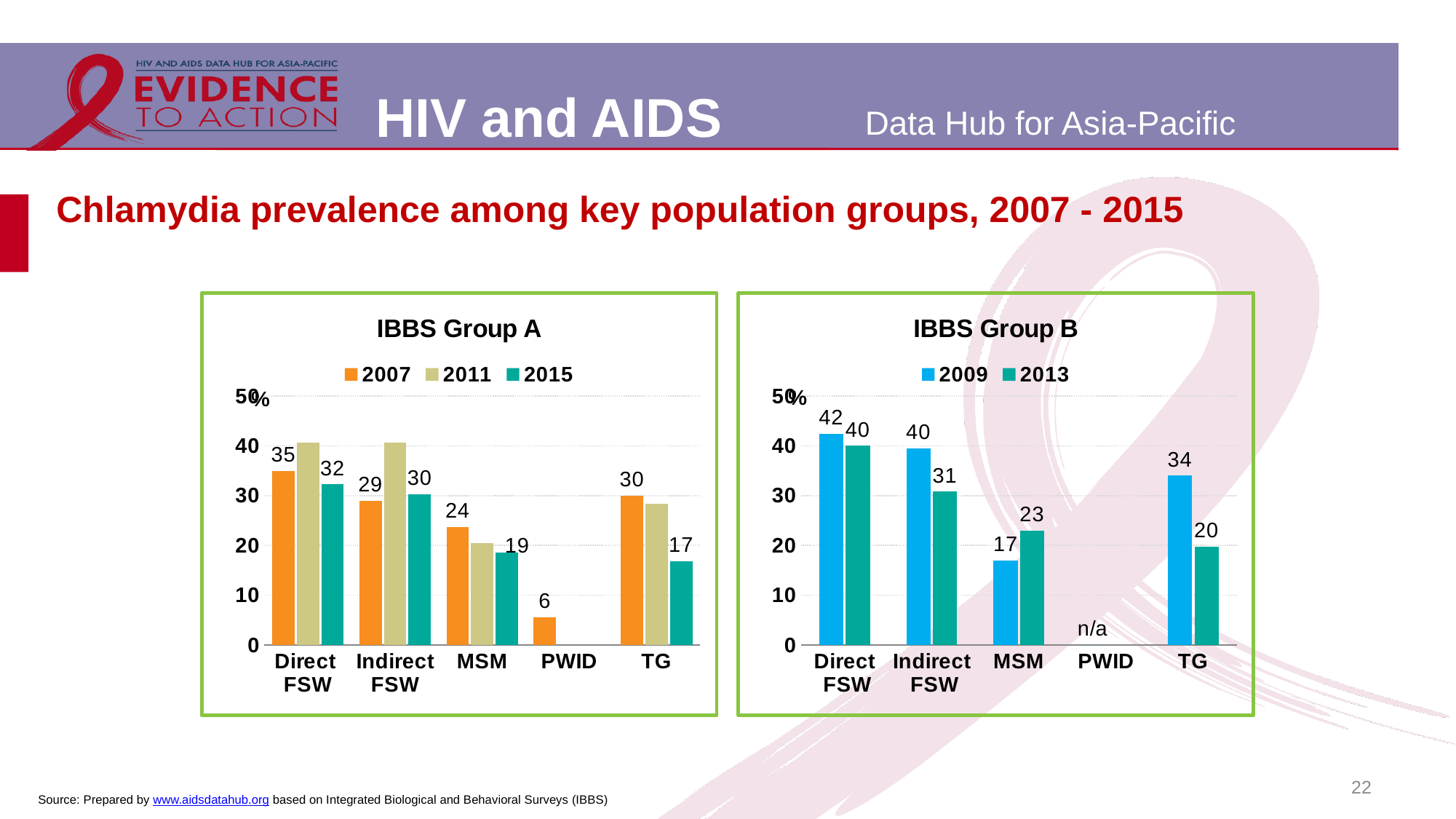
In the IBBS Group B chart, which population group has the highest 2009 value? Direct FSW In the IBBS Group B chart, what is the 2009 value for Direct FSW? 42 In the IBBS Group B chart, is the 2009 or the 2013 value larger for TG? 2009 How many series does the legend of the IBBS Group A chart list? 3 In the IBBS Group A chart, is the 2011 value for MSM greater or less than 30? less In the IBBS Group B chart, what is the difference between the 2009 and 2013 values for Indirect FSW? 9 In the IBBS Group A chart, which population group has the lowest 2007 value? PWID What kind of chart is the IBBS Group B chart? bar chart In the IBBS Group A chart, what is the 2007 value for Direct FSW? 35 In the IBBS Group A chart, what is the 2007 value for PWID? 6 In the IBBS Group A chart, what is the 2015 value for TG? 17 In the IBBS Group B chart, what is the 2013 value for MSM? 23